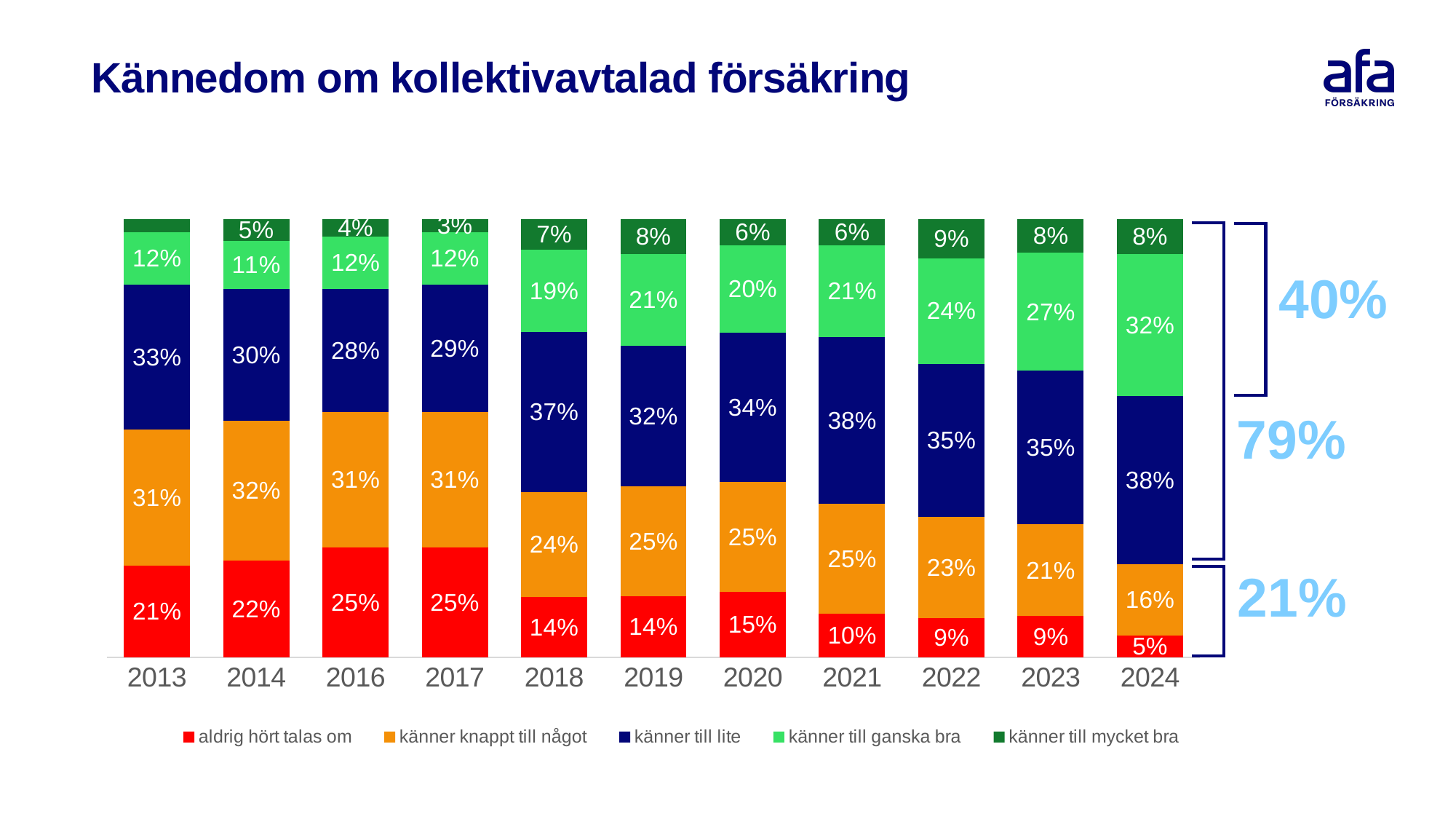
What is the value for "aldrig hört talas om" in 2024? 5% What is the value for "känner till ganska bra" in 2018? 19% What is the value for "känner till mycket bra" in 2022? 9% By how many percentage points does "känner till ganska bra" in 2024 exceed "känner till ganska bra" in 2013? 20 percentage points What is the value for "känner till lite" in 2021? 38% How many series does the legend list? 5 What kind of chart is shown on the slide? Stacked bar chart Does the value for "aldrig hört talas om" rise or fall from 2020 to 2024? Fall How many years are shown on the x axis? 11 Which year has the highest value for "känner till ganska bra"? 2024 Which is larger: "känner knappt till något" in 2014 or in 2024? 2014 Which year has the lowest value for "aldrig hört talas om"? 2024